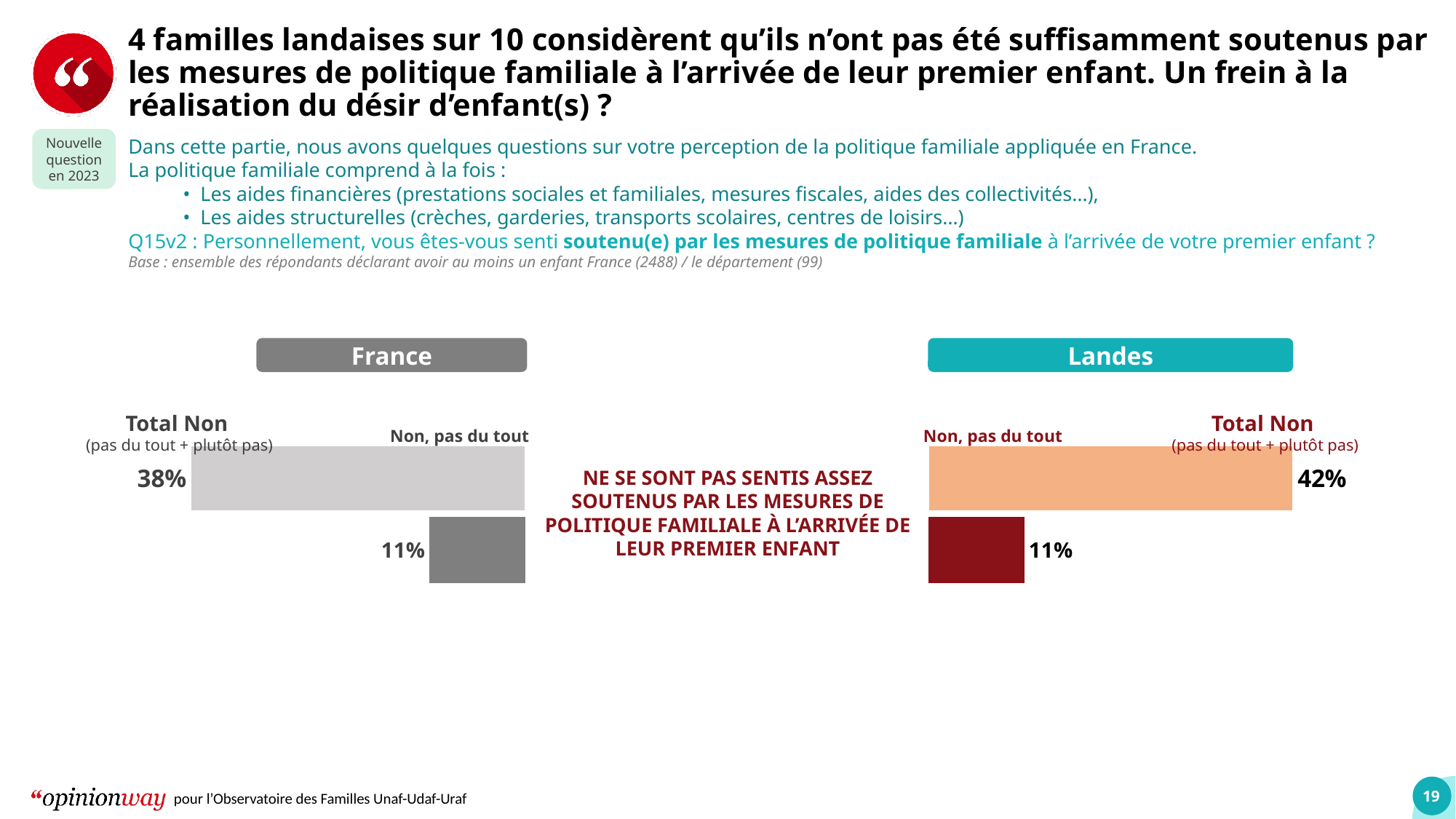
In the Landes chart, what is the value for Total Non (pas du tout + plutôt pas)? 42% What kind of chart is used for the France and Landes data? Bar chart In the France chart, which category has the lowest value? Non, pas du tout In the France chart, what is the difference between Total Non and Non, pas du tout? 27 percentage points In the France chart, what is the value for Non, pas du tout? 11% What is the difference between the Total Non value for Landes and the Total Non value for France? 4 percentage points In the France chart, what is the value for Total Non (pas du tout + plutôt pas)? 38% How many bars are shown in the Landes chart? 2 In the Landes chart, what is the value for Non, pas du tout? 11% In the Landes chart, what is the difference between Total Non and Non, pas du tout? 31 percentage points Which is larger, the Total Non value for France or for Landes? Landes In the Landes chart, which category has the highest value? Total Non (pas du tout + plutôt pas)